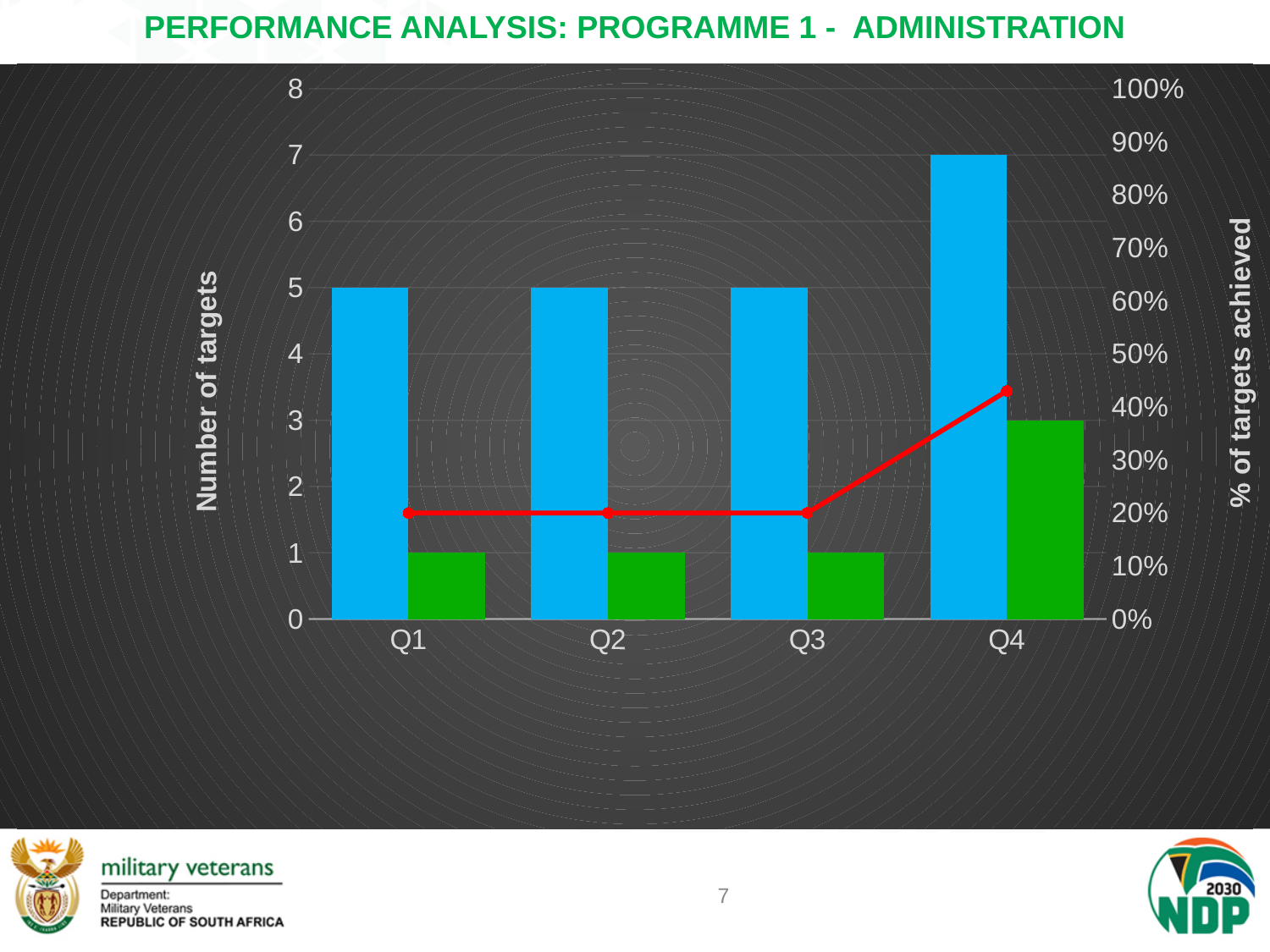
What is the difference between the blue bar for Q4 and the blue bar for Q3? 2 What is the label of the right-hand vertical axis? % of targets achieved What is the value of the blue bar for Q4? 7 Is the red line value for Q4 greater or less than 40%? greater What is the value of the green bar for Q2? 1 What is the difference between the blue bar and the green bar for Q4? 4 How many quarters are shown on the x axis? 4 What is the value of the blue bar for Q1? 5 Is the red line value for Q1 greater or less than 30%? less Which quarter has the highest green bar? Q4 What is the value of the green bar for Q4? 3 Which quarter has the highest blue bar? Q4